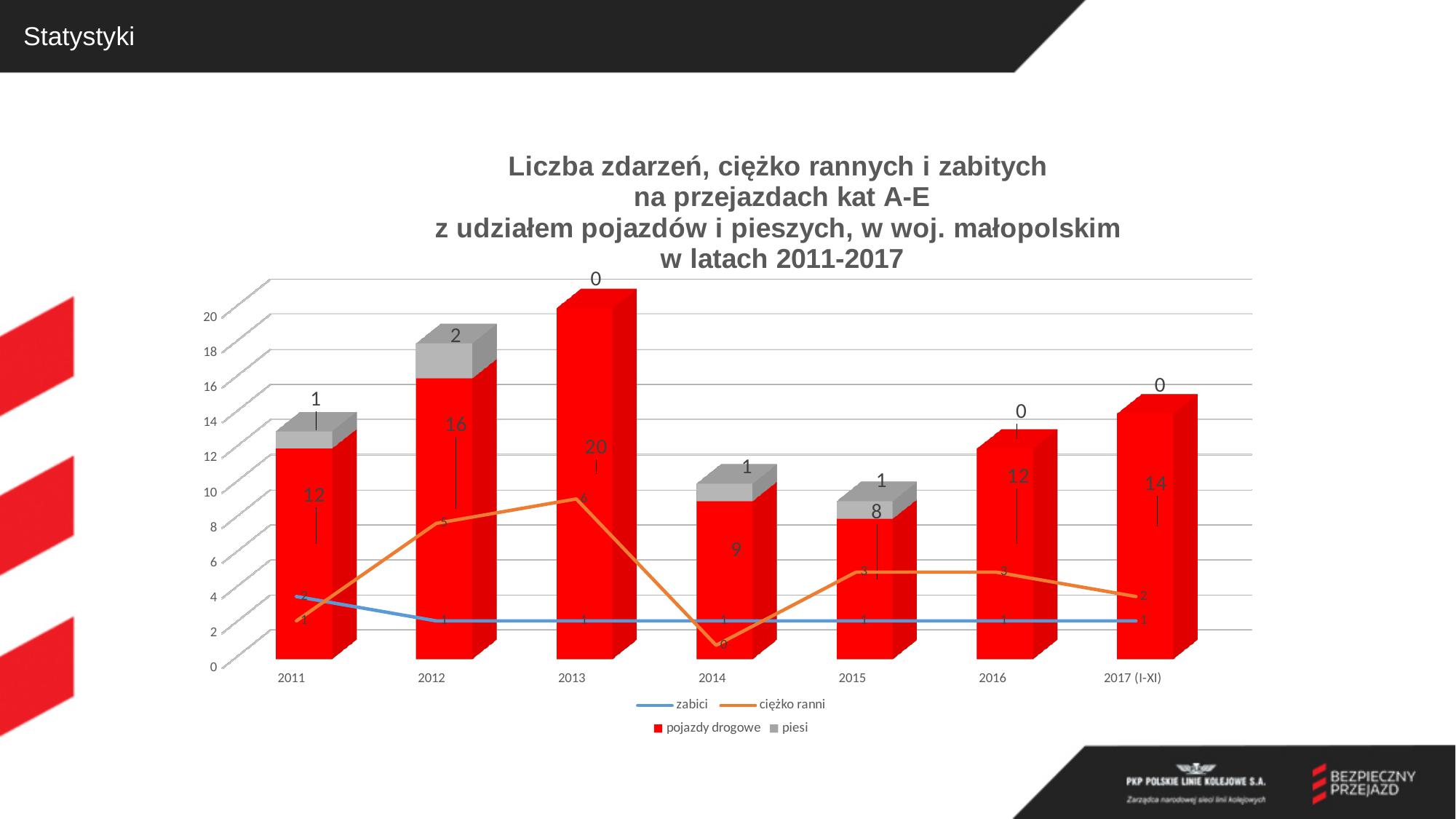
How many series does the legend list? 4 What kind of chart is used to show the pojazdy drogowe and piesi series? Stacked bar chart Which year has the larger pojazdy drogowe value, 2016 or 2017 (I-XI)? 2017 (I-XI) Which year has the highest value for pojazdy drogowe? 2013 How many years are shown on the x axis? 7 What is the value for piesi in 2012? 2 What is the total of the stacked bar (pojazdy drogowe plus piesi) for 2011? 13 What is the value for pojazdy drogowe in 2013? 20 What is the value for pojazdy drogowe in 2017 (I-XI)? 14 What is the difference between the pojazdy drogowe values for 2013 and 2015? 12 What is the total of the stacked bar (pojazdy drogowe plus piesi) for 2012? 18 Which year has the lowest value for pojazdy drogowe? 2015